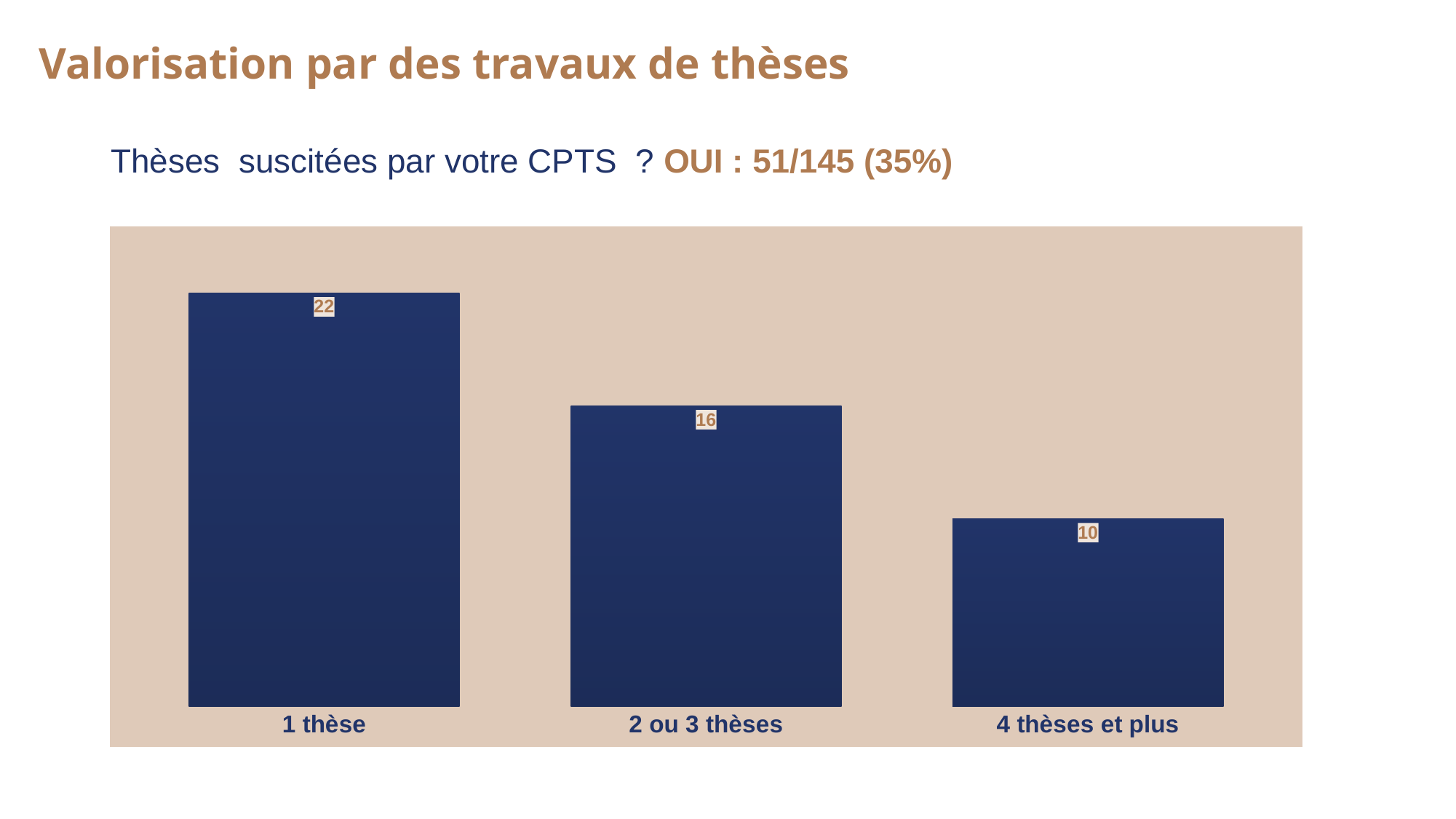
What is the difference between the values for "1 thèse" and "2 ou 3 thèses"? 6 What is the value for "2 ou 3 thèses"? 16 What is the total of the three values shown in the chart? 48 Which is larger, the value for "2 ou 3 thèses" or the value for "4 thèses et plus"? 2 ou 3 thèses Do the values rise or fall from left to right across the categories? fall What is the value for "4 thèses et plus"? 10 How many categories are shown in the chart? 3 What kind of chart is shown on the slide? bar chart Which category has the lowest value? 4 thèses et plus Which category has the highest value? 1 thèse What is the difference between the values for "2 ou 3 thèses" and "4 thèses et plus"? 6 What is the value for "1 thèse"? 22